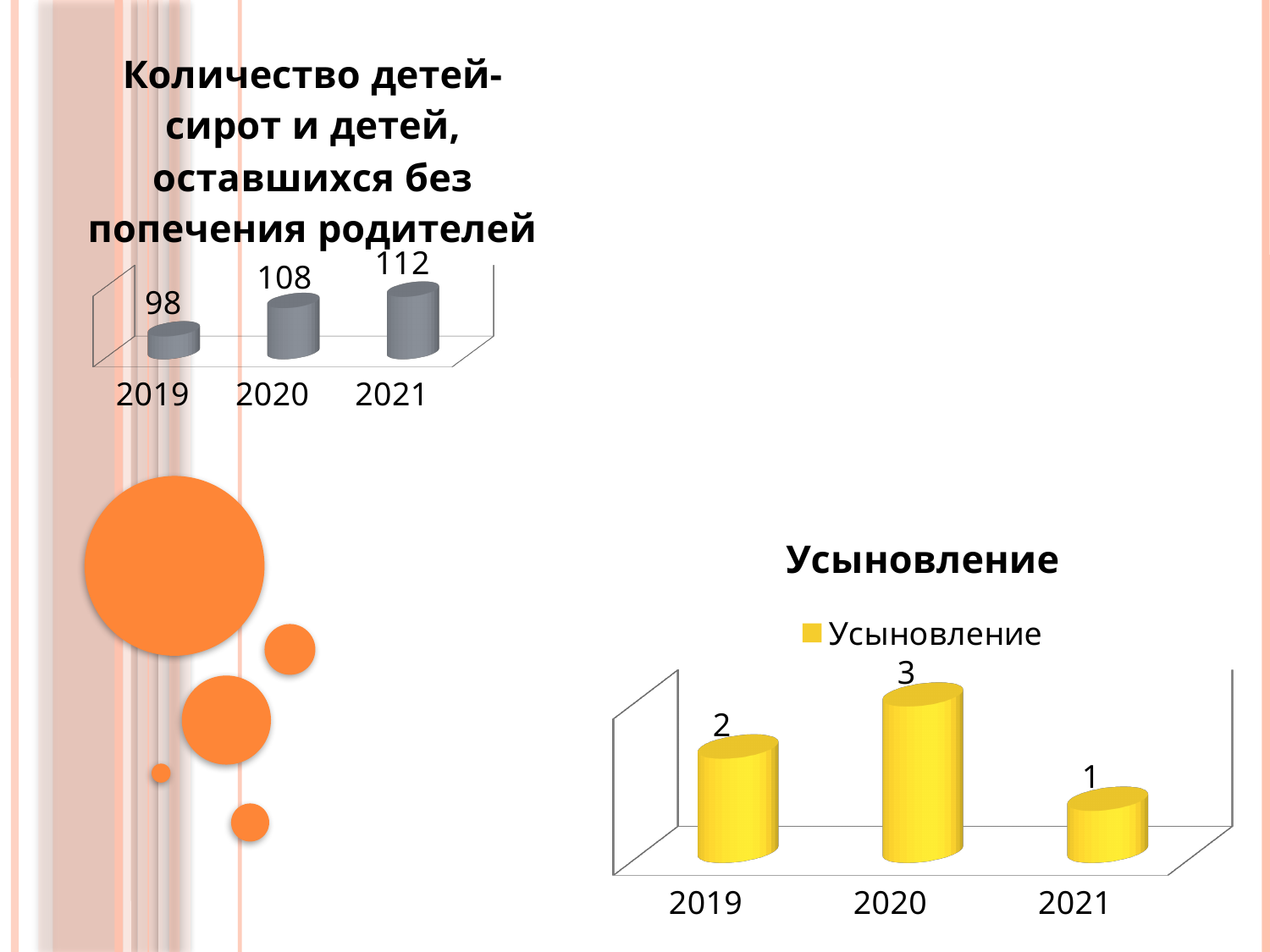
In the chart titled "Количество детей-сирот и детей, оставшихся без попечения родителей", what is the value for 2021? 112 In the chart titled "Усыновление", what is the value for 2021? 1 In the chart titled "Количество детей-сирот и детей, оставшихся без попечения родителей", what is the value for 2019? 98 In the chart titled "Количество детей-сирот и детей, оставшихся без попечения родителей", which year has the highest value? 2021 In the chart titled "Количество детей-сирот и детей, оставшихся без попечения родителей", do the values rise or fall from 2019 to 2021? rise In the chart titled "Количество детей-сирот и детей, оставшихся без попечения родителей", what is the difference between the values for 2021 and 2019? 14 In the chart titled "Усыновление", which is larger, the value for 2019 or the value for 2020? 2020 How many categories are shown in the chart titled "Усыновление"? 3 What kind of chart is the chart titled "Усыновление"? bar chart In the chart titled "Усыновление", which year has the lowest value? 2021 In the chart titled "Усыновление", what is the difference between the values for 2020 and 2021? 2 In the chart titled "Усыновление", what is the value for 2020? 3